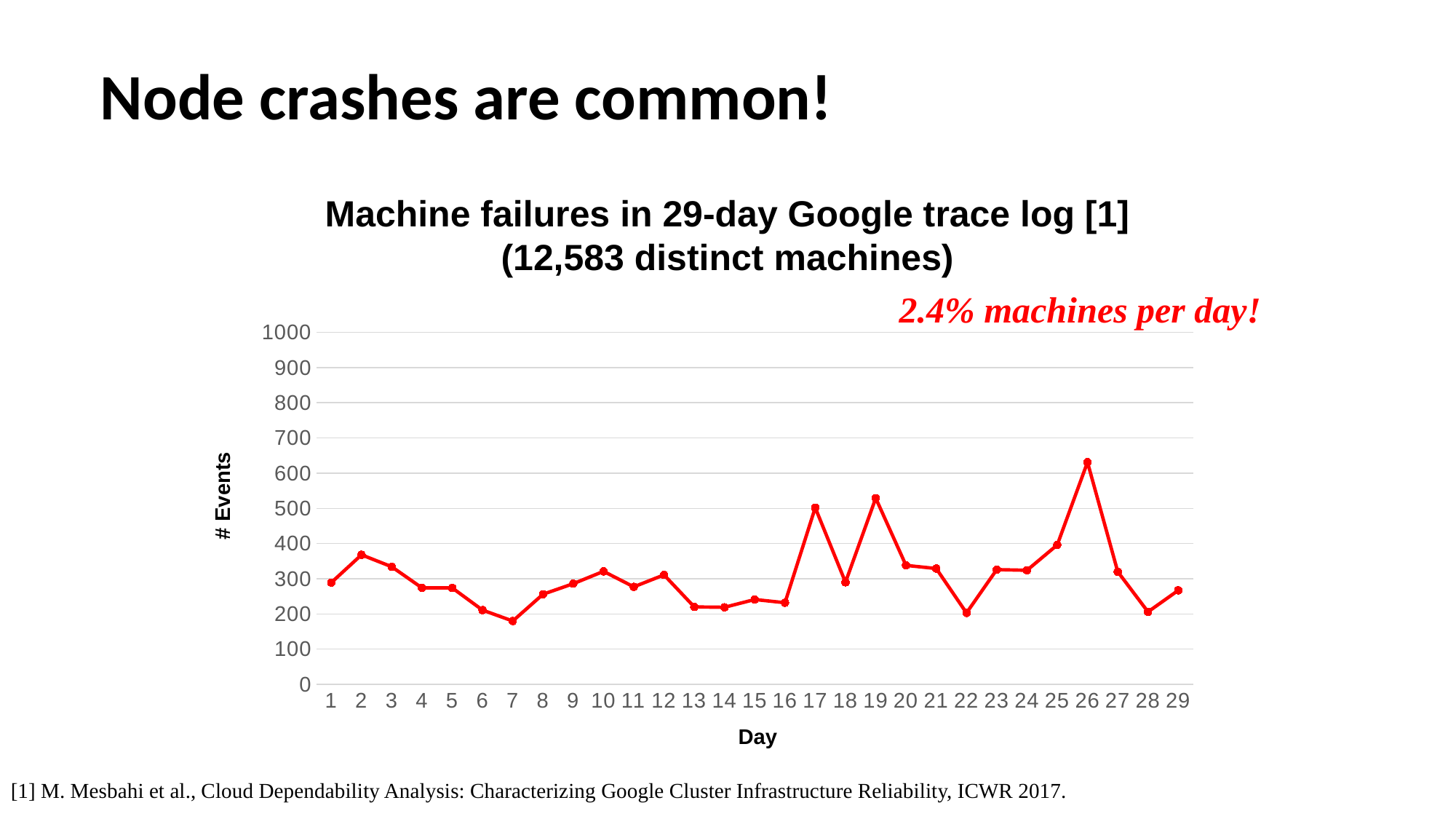
Is the value for day 17 greater or less than 400? greater Is the value for day 7 greater or less than 200? less How many days (data points) are plotted on the x axis? 29 Which day has more events, day 2 or day 7? 2 Is the value for day 13 greater or less than 300? less What is the label of the y axis? # Events On which day is the number of events highest? 26 Which day has more events, day 26 or day 19? 26 On which day is the number of events lowest? 7 What kind of chart is shown on the slide? line chart